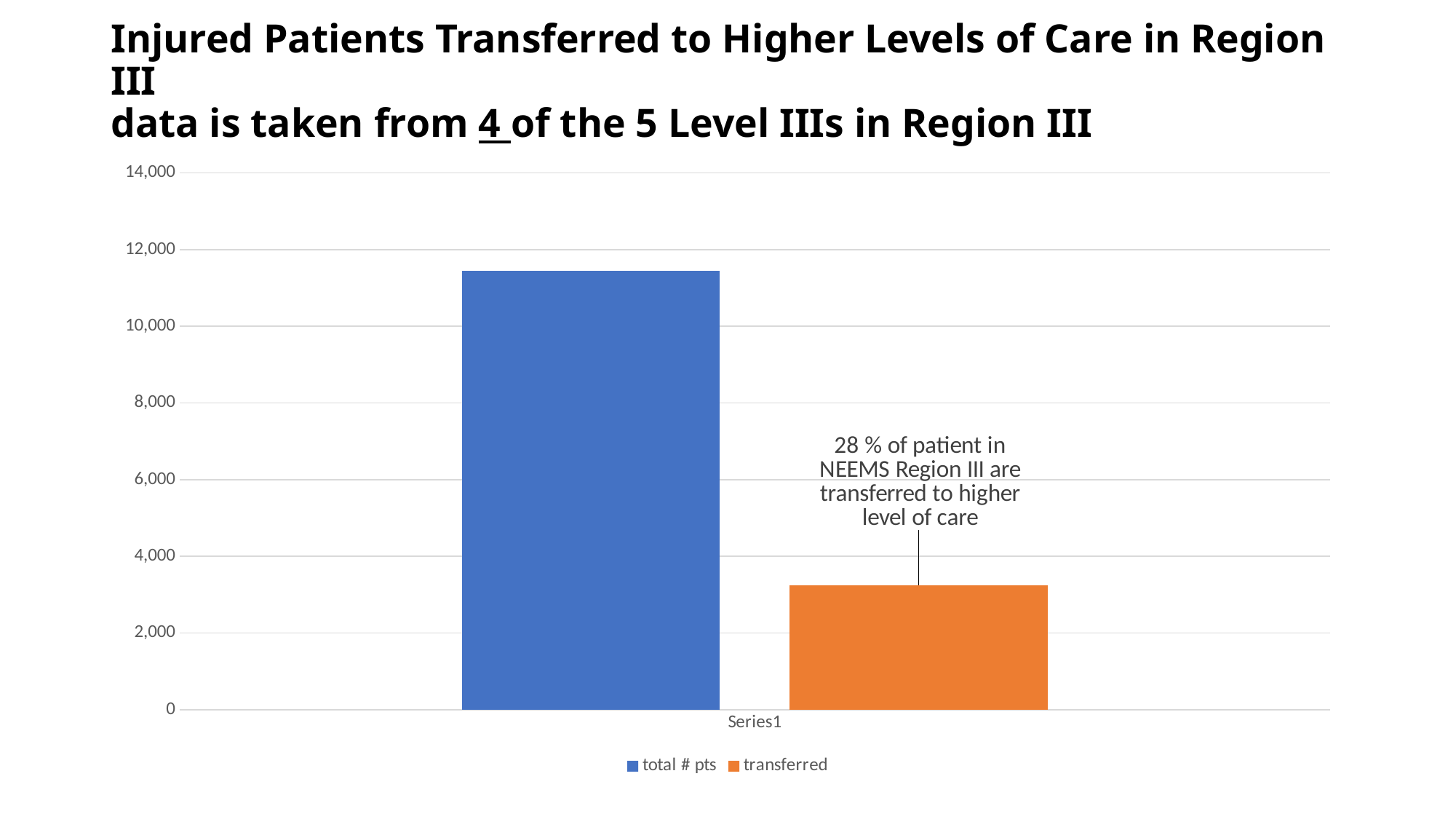
Which series has the shortest bar? transferred What colour is the bar for the transferred series? orange According to the annotation on the chart, what percentage of patients in NEEMS Region III are transferred to a higher level of care? 28 % Is the value for transferred greater or less than 4,000? less Which series has the highest value? total # pts Is the value for total # pts greater or less than 10,000? greater Is the value for total # pts greater or less than 12,000? less How many categories are shown on the x axis? 1 How many series does the legend list? 2 Which series has the taller bar, total # pts or transferred? total # pts What kind of chart is shown on the slide? bar chart